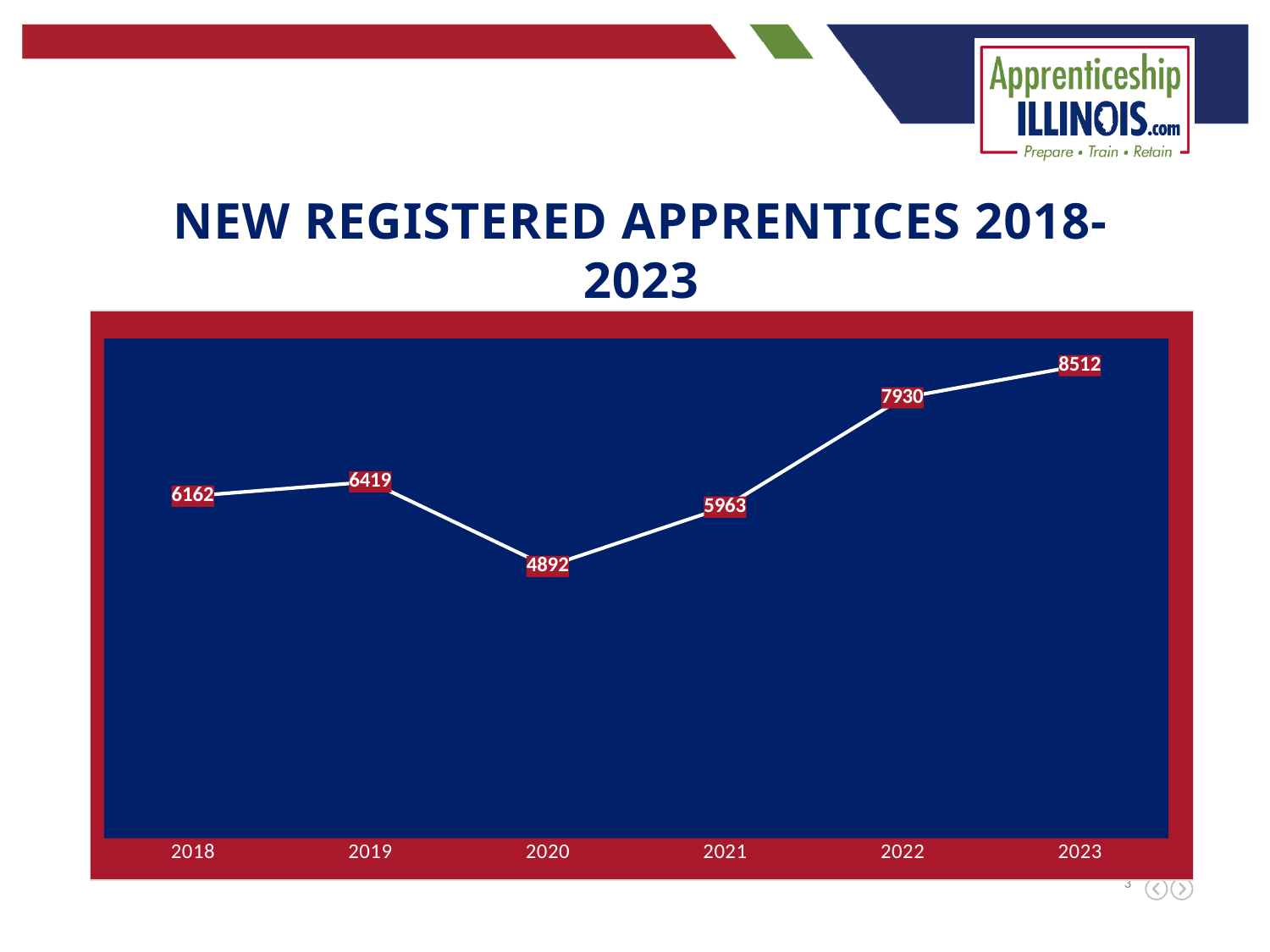
How many years are plotted on the chart? 6 Do the values rise or fall from 2020 to 2023? rise Which year has the lowest value? 2020 What is the value for 2020? 4892 Which year has the highest value? 2023 What is the difference between the values for 2019 and 2020? 1527 What is the difference between the values for 2023 and 2022? 582 Which is larger, the value for 2021 or the value for 2018? 2018 What is the value for 2022? 7930 What kind of chart is shown? line chart What is the title of the chart? NEW REGISTERED APPRENTICES 2018-2023 What is the value for 2018? 6162